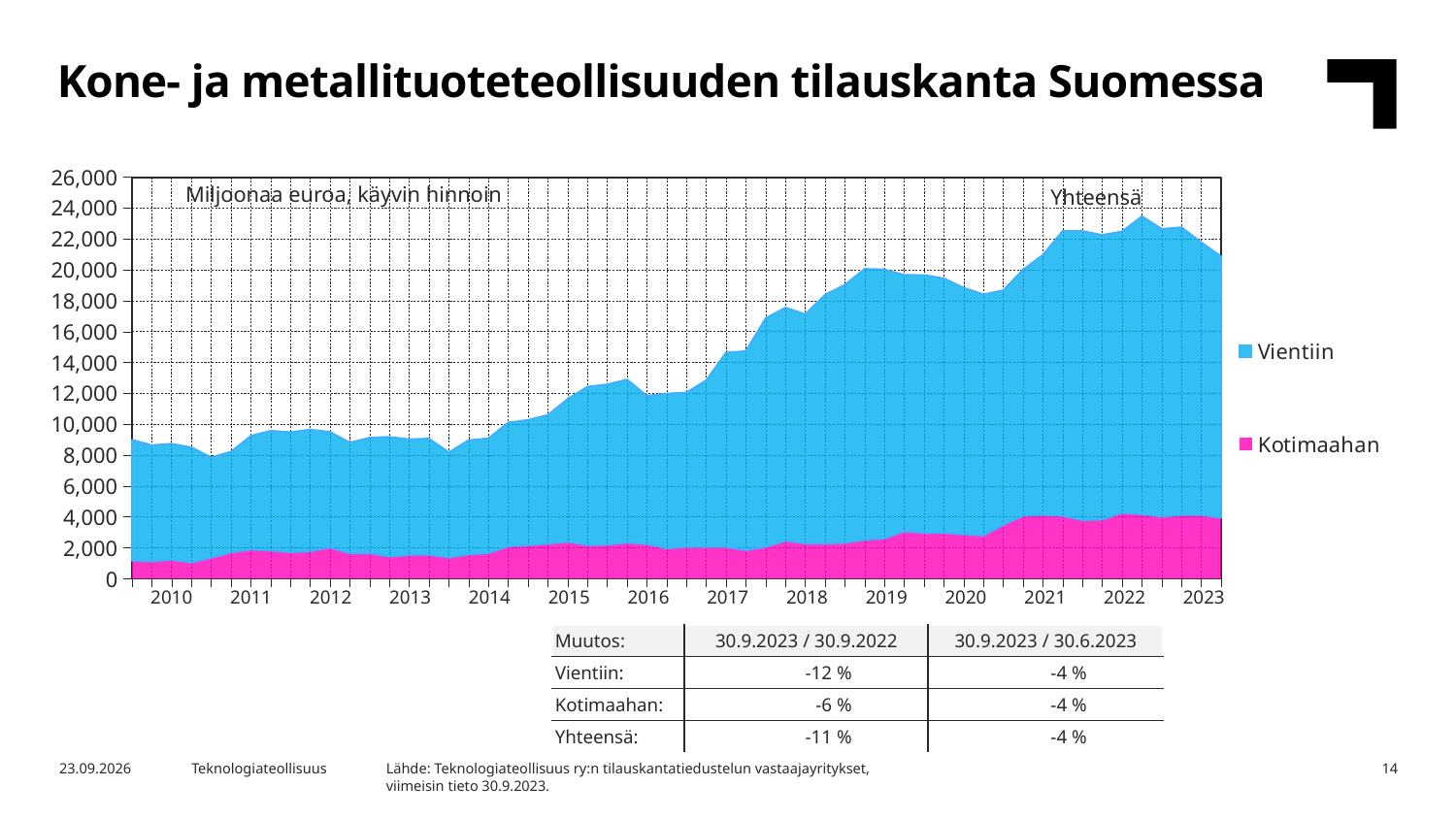
Which series is larger throughout the chart, Vientiin or Kotimaahan? Vientiin Is the total order backlog at its 2022 peak greater or less than 22,000? greater Is the total order backlog at the start of 2010 greater or less than 6,000? greater How many series does the chart legend list? 2 Does the total order backlog generally rise or fall from 2016 to 2019? rise In which year does the total (Yhteensä) order backlog reach its highest point? 2022 Is the Kotimaahan value in 2010 greater or less than 2,000? less How many years are labelled on the x axis of the chart? 14 What unit label is printed inside the chart area? Miljoonaa euroa, käyvin hinnoin What kind of chart is shown on the slide? Stacked area chart What are the two series named in the chart legend? Vientiin and Kotimaahan